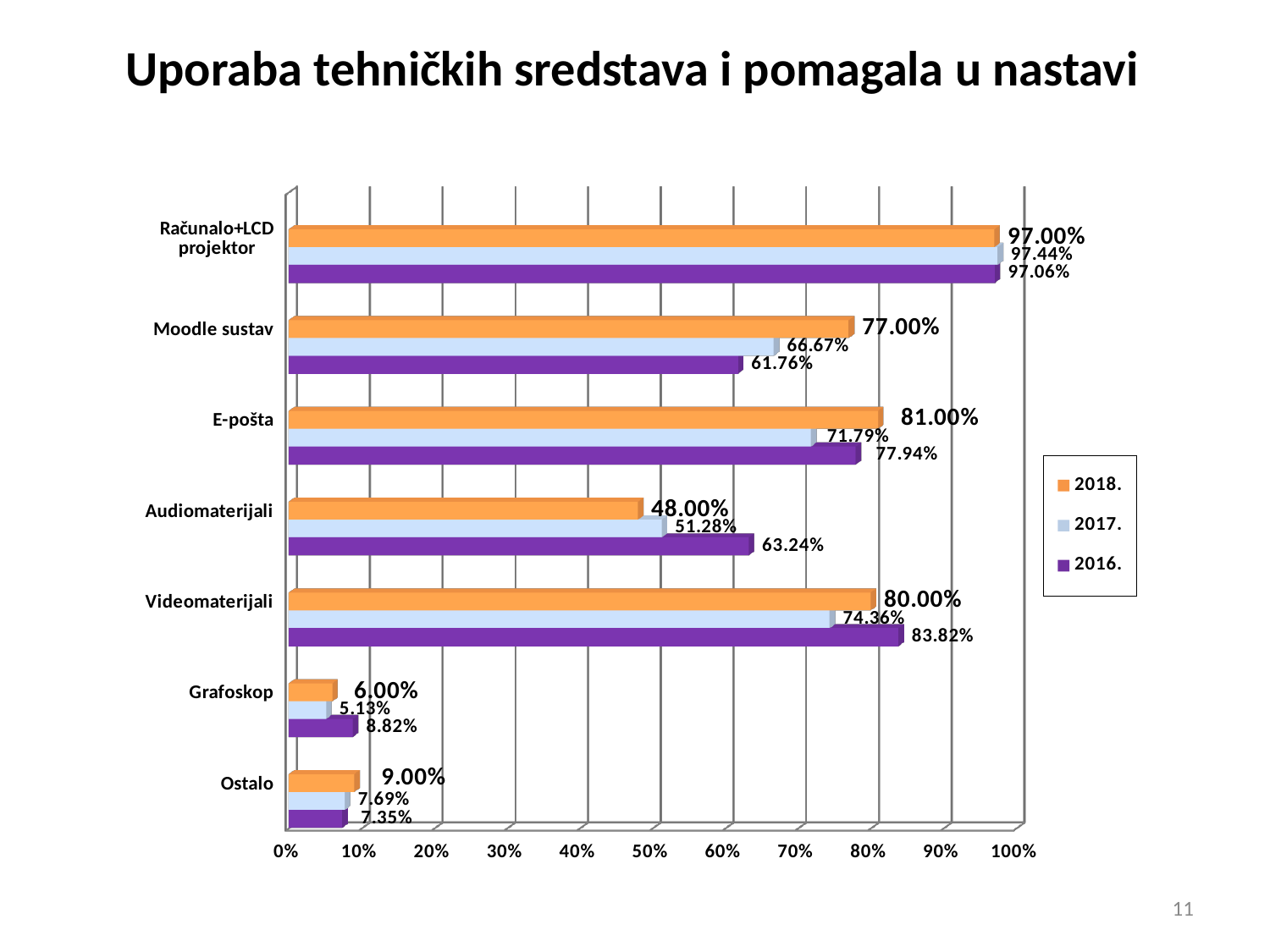
What is the value for E-pošta in 2017.? 71.79% What is the value for Moodle sustav in 2018.? 77.00% Which is larger for Videomaterijali: the 2016. value or the 2018. value? 2016. Which category has the highest value in the 2018. series? Računalo+LCD projektor How many categories are shown on the chart? 7 What kind of chart is shown on the slide? Bar chart What is the title of the slide? Uporaba tehničkih sredstava i pomagala u nastavi How many series does the legend list? 3 Is the 2017. value for Audiomaterijali greater or less than 40%? greater What is the value for Audiomaterijali in 2016.? 63.24% Which category has the lowest value in the 2017. series? Grafoskop What is the difference between the 2018. and 2016. values for Moodle sustav? 15.24%